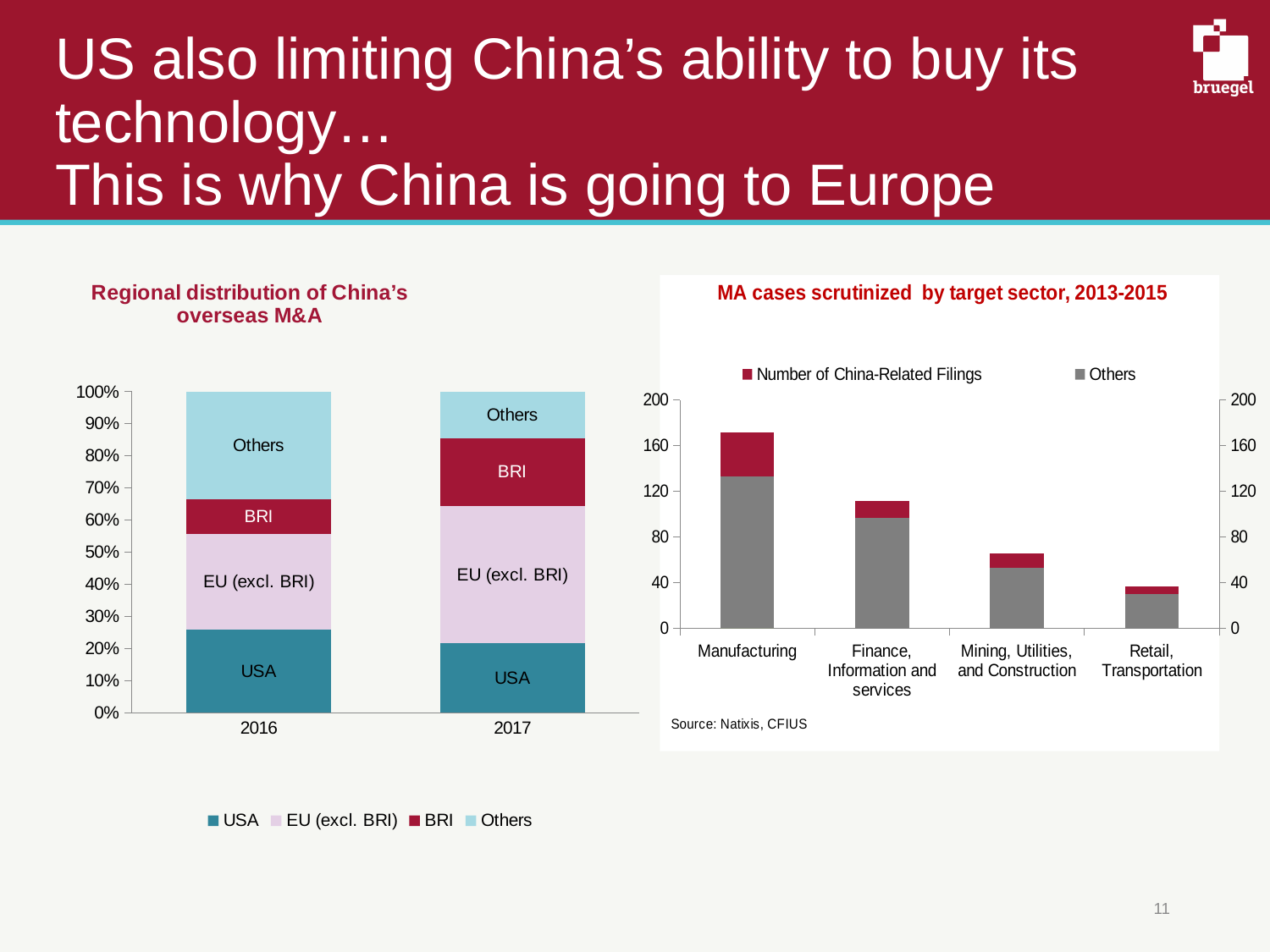
How many series does the legend of the left chart, 'Regional distribution of China's overseas M&A', list? 4 How many target sectors are shown on the x axis of the right chart, 'MA cases scrutinized by target sector, 2013-2015'? 4 What kind of chart is the left chart, 'Regional distribution of China's overseas M&A'? Stacked bar chart In the left chart, 'Regional distribution of China's overseas M&A', is the BRI share larger in 2016 or in 2017? 2017 In the left chart, 'Regional distribution of China's overseas M&A', is the USA share in 2016 greater or less than 20%? greater In the right chart, 'MA cases scrutinized by target sector, 2013-2015', is the 'Others' value for Manufacturing greater or less than 120? greater How many years are shown on the x axis of the left chart, 'Regional distribution of China's overseas M&A'? 2 In the left chart, 'Regional distribution of China's overseas M&A', is the Others share larger in 2016 or in 2017? 2016 How many series does the legend of the right chart, 'MA cases scrutinized by target sector, 2013-2015', list? 2 In the right chart, 'MA cases scrutinized by target sector, 2013-2015', which sector has the lowest total number of cases? Retail, Transportation In the right chart, 'MA cases scrutinized by target sector, 2013-2015', which sector has the highest total number of cases? Manufacturing What is the title of the right chart on the slide? MA cases scrutinized by target sector, 2013-2015